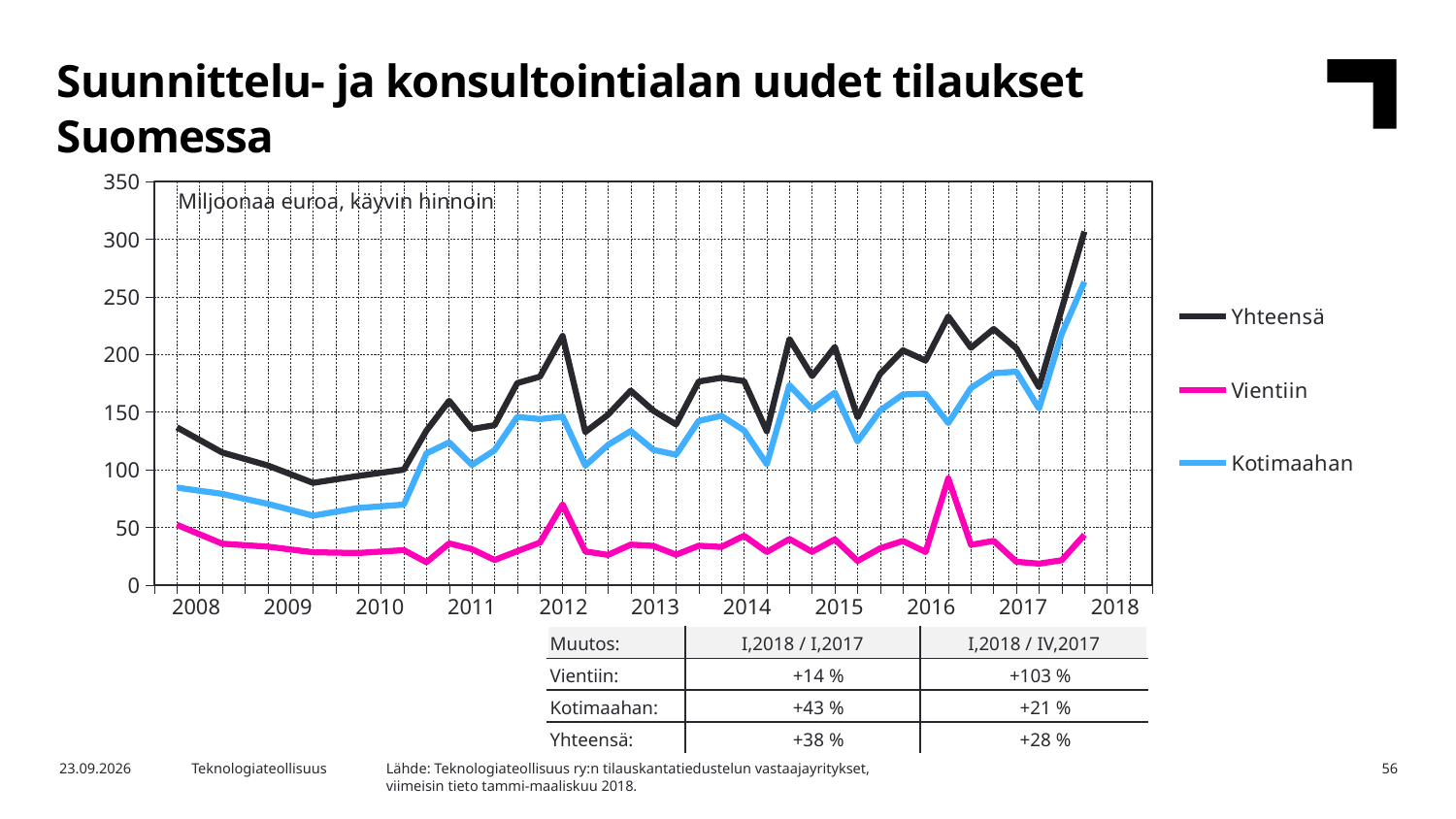
Which series are listed in the chart legend? Yhteensä, Vientiin, Kotimaahan Does the Yhteensä line rise or fall from 2008 to 2009? fall Is the lowest value for Yhteensä in 2009 greater or less than 100? less Is the peak value for Vientiin in 2016 greater or less than 100? less What kind of chart is shown on the slide? line chart Is the value for Kotimaahan at the last point in 2018 greater or less than 200? greater Which series has the highest values throughout the chart? Yhteensä How many series does the legend list? 3 Which is larger at the start of 2008, Kotimaahan or Vientiin? Kotimaahan What unit is stated in the text inside the chart area? Miljoonaa euroa, käyvin hinnoin Which series has the lowest values throughout the chart? Vientiin